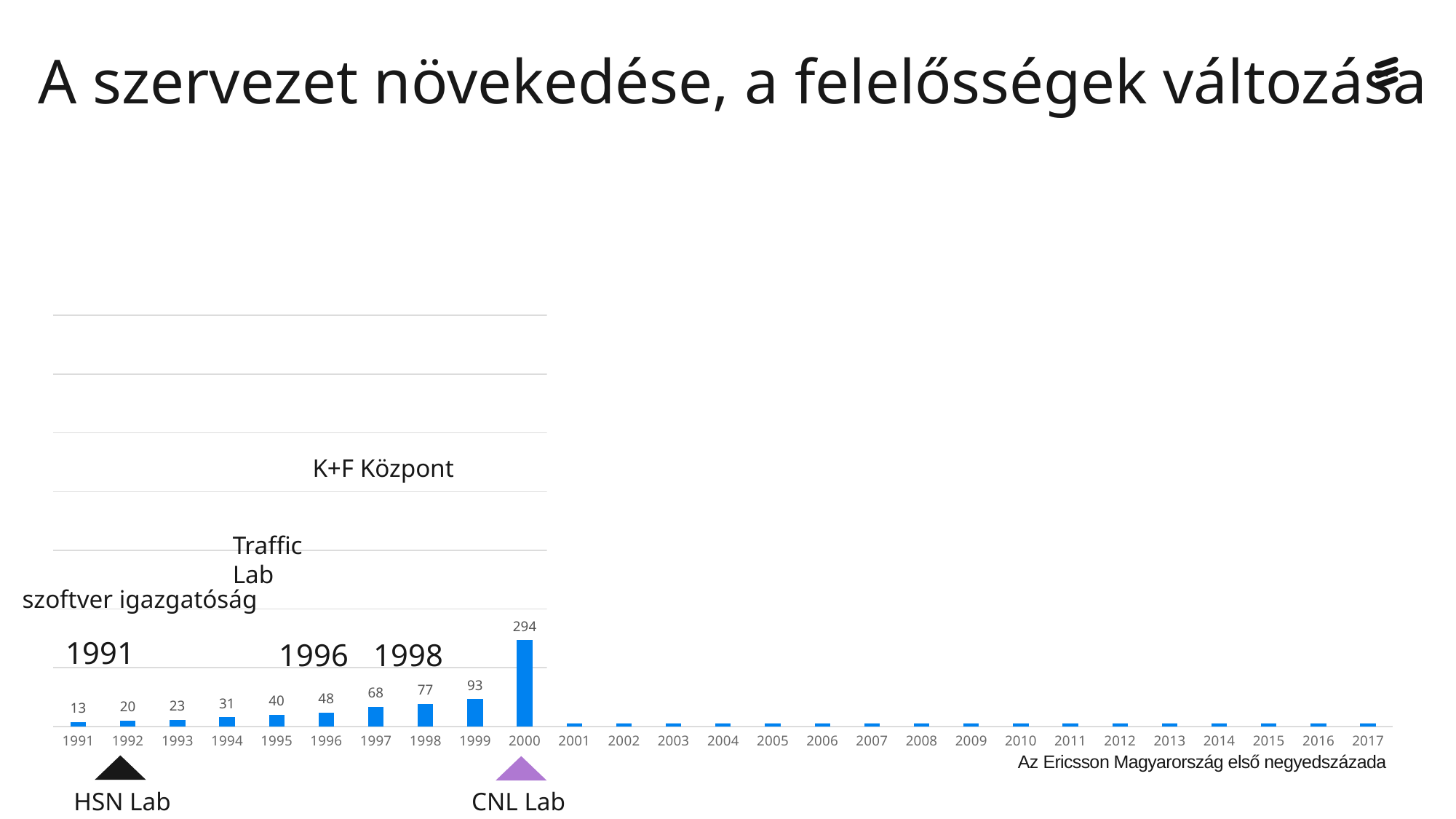
What is the difference between the values for 1997 and 1996? 20 What is the difference between the values for 2000 and 1999? 201 What is the value shown for 1991? 13 What is the value shown for 1996? 48 What kind of chart is shown on the slide? bar chart How many years are shown on the x axis? 27 Which is larger, the value for 1994 or the value for 1995? 1995 Which year has the highest labelled value? 2000 What is the value shown for 1998? 77 Do the labelled values rise or fall from 1991 to 2000? rise Which year has the lowest labelled value? 1991 What is the value shown for 2000? 294